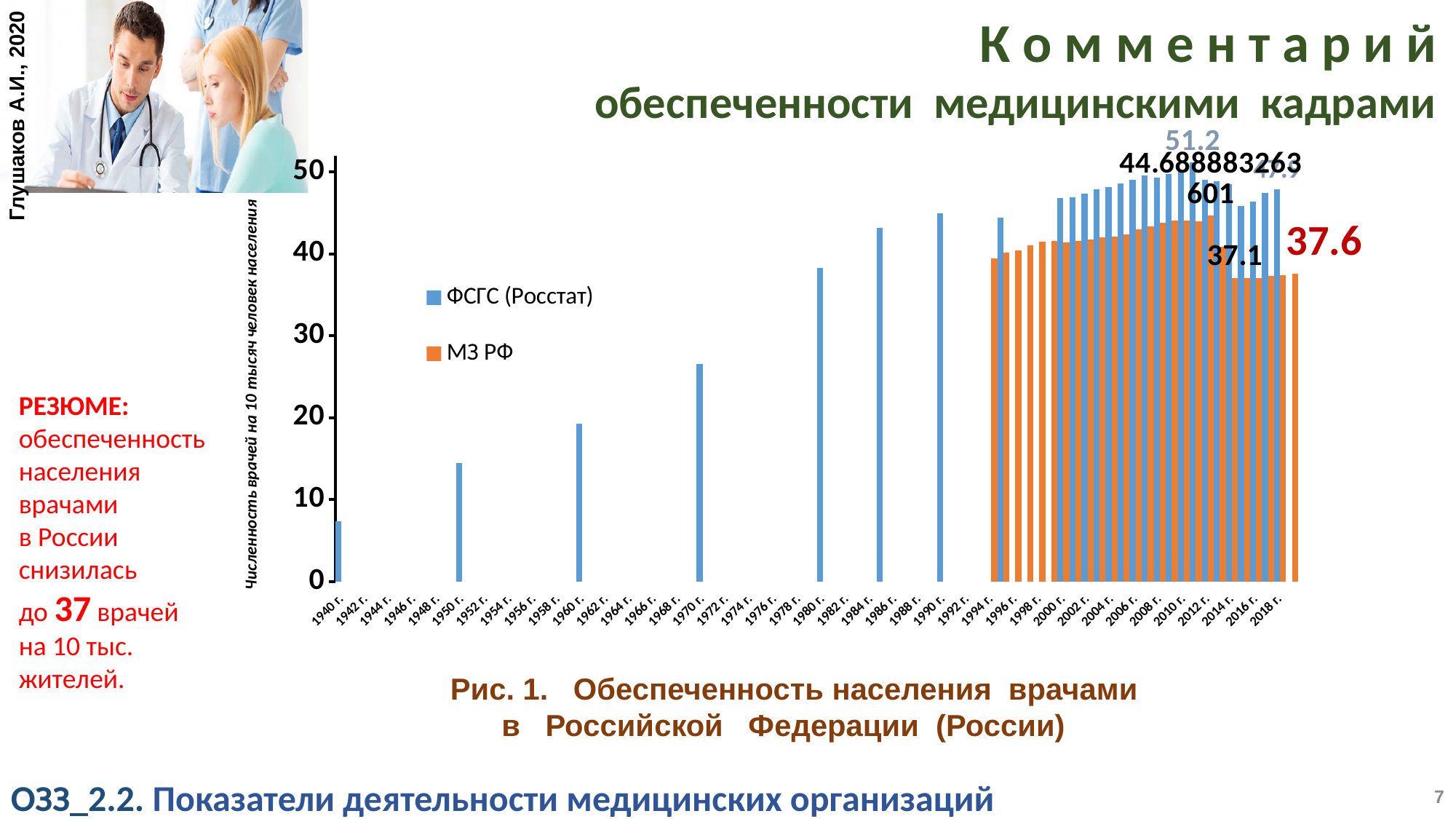
What is the title of the vertical axis of the chart? Численность врачей на 10 тысяч человек населения What is the highest labelled value for the ФСГС (Росстат) series? 51.2 Is the ФСГС (Росстат) value for 1940 г. greater or less than 10? less How many series does the legend of the chart list? 2 What kind of chart is shown in Рис. 1? bar chart Is the ФСГС (Росстат) value for 1970 г. greater or less than 20? greater What are the two series named in the chart legend? ФСГС (Росстат) and МЗ РФ What is the value for ФСГС (Росстат) in 2018 г.? 47.9 In 2018 г., which series has the larger value, ФСГС (Росстат) or МЗ РФ? ФСГС (Росстат) Do the ФСГС (Росстат) values rise or fall from 1940 г. to 1990 г.? rise